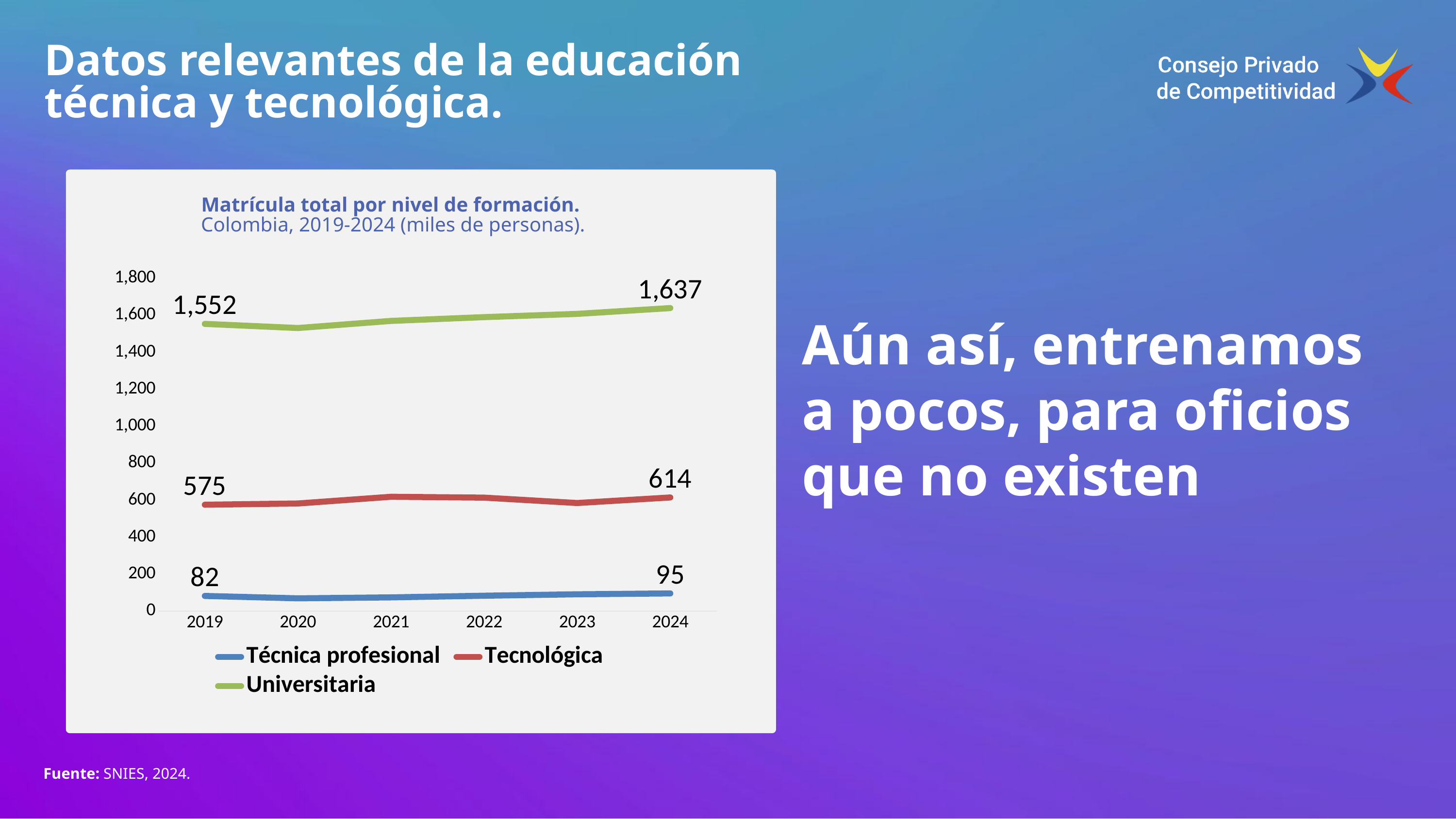
How many series does the legend list? 3 Is the value for Tecnológica in 2021 greater or less than 400? greater What is the value for Tecnológica in 2024? 614 What is the difference between the Universitaria values in 2024 and 2019? 85 What is the value for Universitaria in 2024? 1,637 What is the value for Técnica profesional in 2024? 95 Which series has the highest values across all years? Universitaria What is the value for Universitaria in 2019? 1,552 What is the difference between the Tecnológica and Técnica profesional values in 2019? 493 What is the value for Tecnológica in 2019? 575 What type of chart is shown on the slide? line chart How many years are shown on the x axis? 6